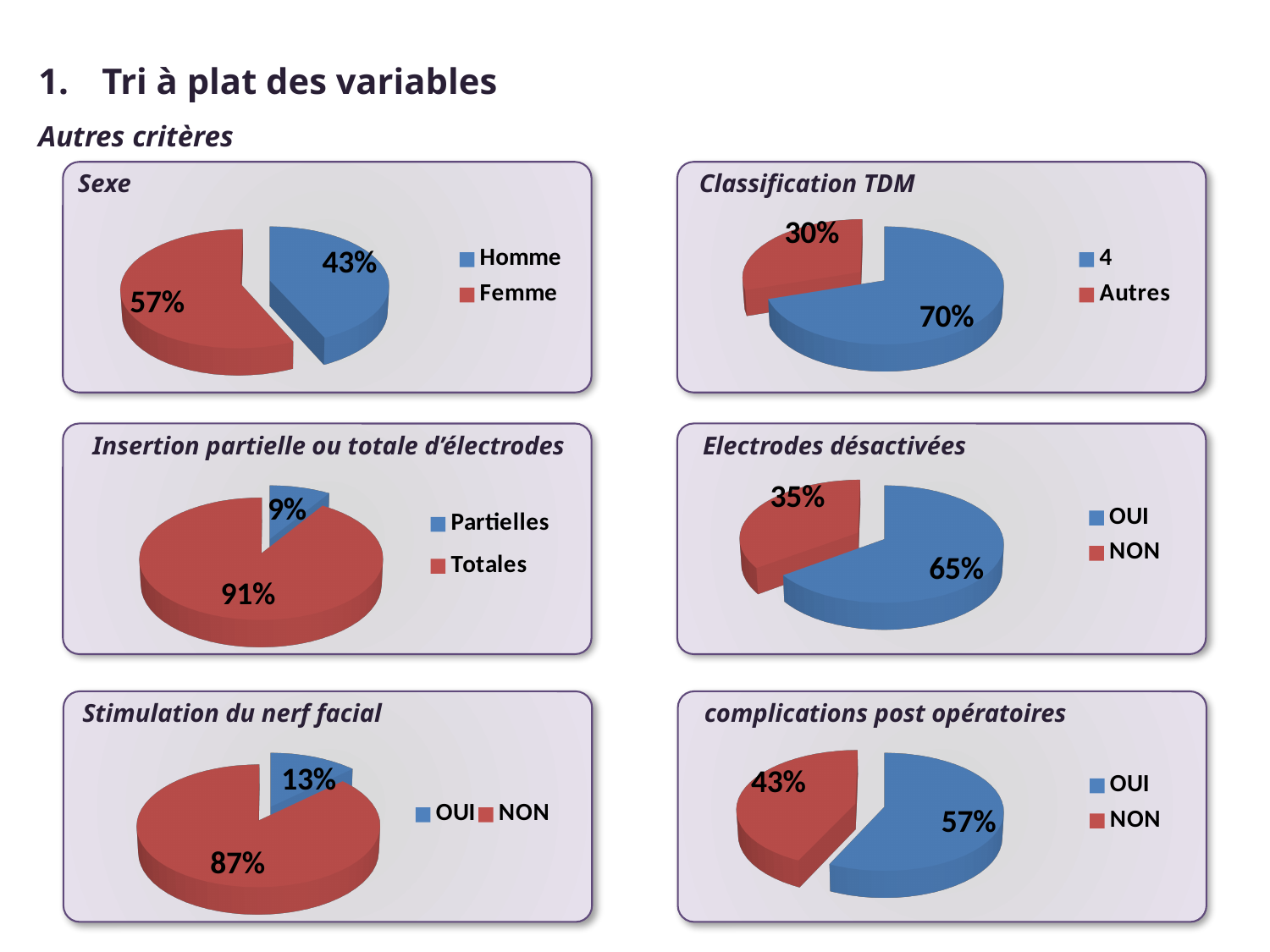
In the 'Electrodes désactivées' chart, what percentage is NON? 35% In the 'complications post opératoires' chart, what percentage is NON? 43% In the 'Electrodes désactivées' chart, which is larger, OUI or NON? OUI In the 'Classification TDM' chart, which category is the largest? 4 What type of chart is the 'Sexe' chart? Pie chart In the 'Stimulation du nerf facial' chart, which category is the smallest? OUI In the 'Sexe' chart, what percentage is Homme? 43% In the 'Sexe' chart, what percentage is Femme? 57% In the 'Stimulation du nerf facial' chart, what percentage is OUI? 13% In the 'Insertion partielle ou totale d'électrodes' chart, what is the difference between Totales and Partielles? 82% In the 'Insertion partielle ou totale d'électrodes' chart, what percentage is Partielles? 9% In the 'Classification TDM' chart, what share does the '4' slice have? 70%